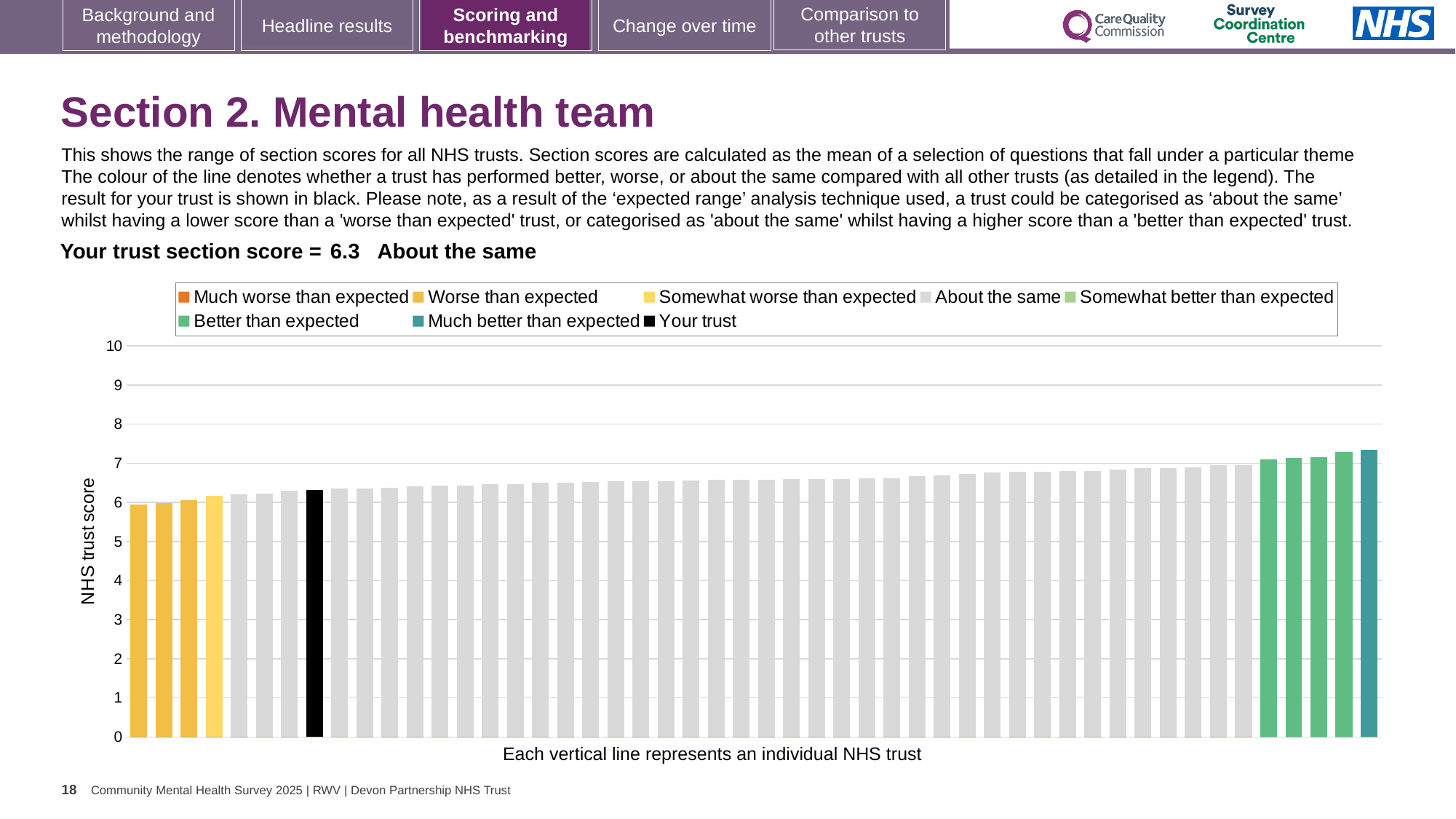
What is the label on the y axis of the chart? NHS trust score Is the value for the rightmost bar greater or less than 8? less How is your trust's section score categorised compared with other trusts? About the same How many bars are coloured as 'Much better than expected'? 1 What kind of chart is shown on the slide? bar chart Is the value for the rightmost bar greater or less than 7? greater How many entries does the chart legend list? 8 Do the bar values rise or fall from left to right along the x axis? rise What is the section score for your trust shown on the slide? 6.3 Is the value for the leftmost bar greater or less than 5? greater Which legend category does the highest bar belong to? Much better than expected